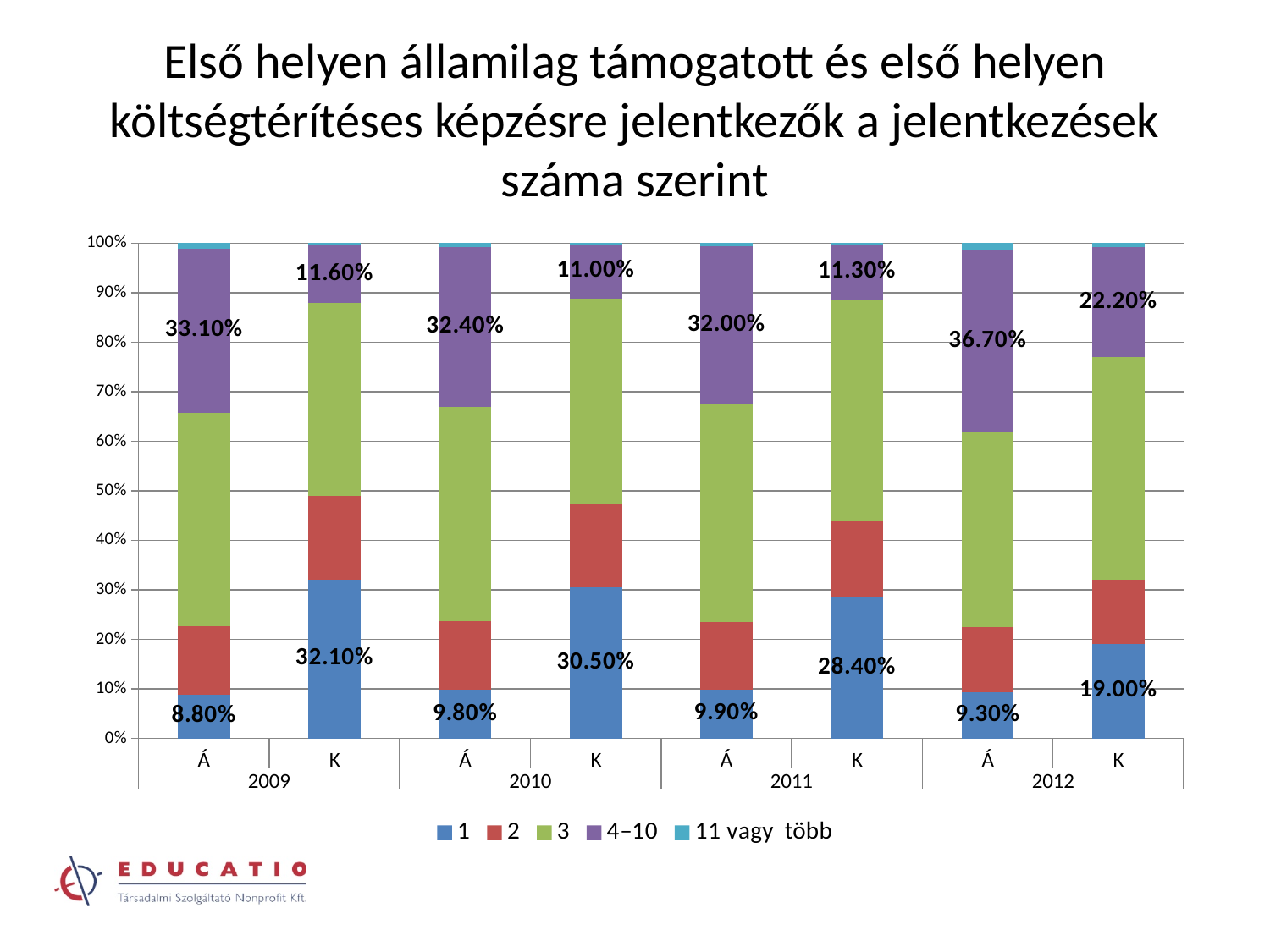
Among the K bars, which year has the highest value for series 1? 2009 What is the value of series 4–10 for K in 2010? 11.00% What is the difference between the series 1 values for K in 2009 and K in 2012? 13.10% How many bars are plotted in the chart? 8 What kind of chart is shown on the slide? stacked bar chart Among the Á bars, which year has the lowest value for series 1? 2009 Is the value of series 3 for K in 2012 greater or less than 40%? greater What is the value of series 1 for K in 2012? 19.00% How many series does the legend list? 5 Which is larger, the series 4–10 value for Á in 2011 or for K in 2011? Á in 2011 What is the value of series 1 for Á in 2009? 8.80% What is the value of series 4–10 for Á in 2012? 36.70%